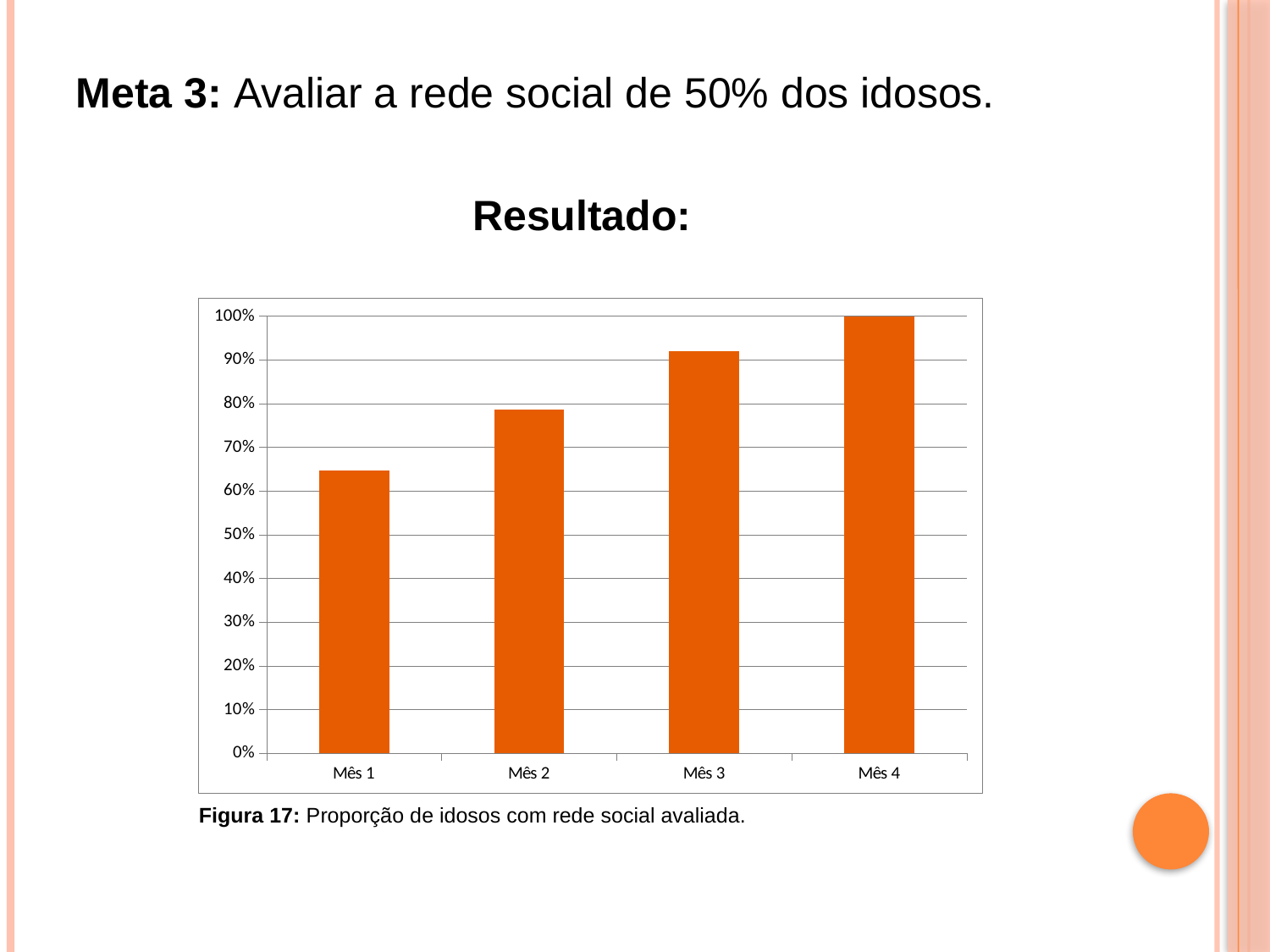
Is the value for Mês 1 greater or less than 60%? greater Which is larger, the value for Mês 2 or the value for Mês 3? Mês 3 What is the figure caption below the chart? Figura 17: Proporção de idosos com rede social avaliada. Which month has the highest value in the chart? Mês 4 Which month has the lowest value in the chart? Mês 1 How many months (categories) are shown on the x axis of the chart? 4 What type of chart is shown on the slide? bar chart Do the values rise or fall from Mês 1 to Mês 4? rise Is the value for Mês 3 greater or less than 90%? greater Is the value for Mês 2 greater or less than 70%? greater What is the value for Mês 4? 100%